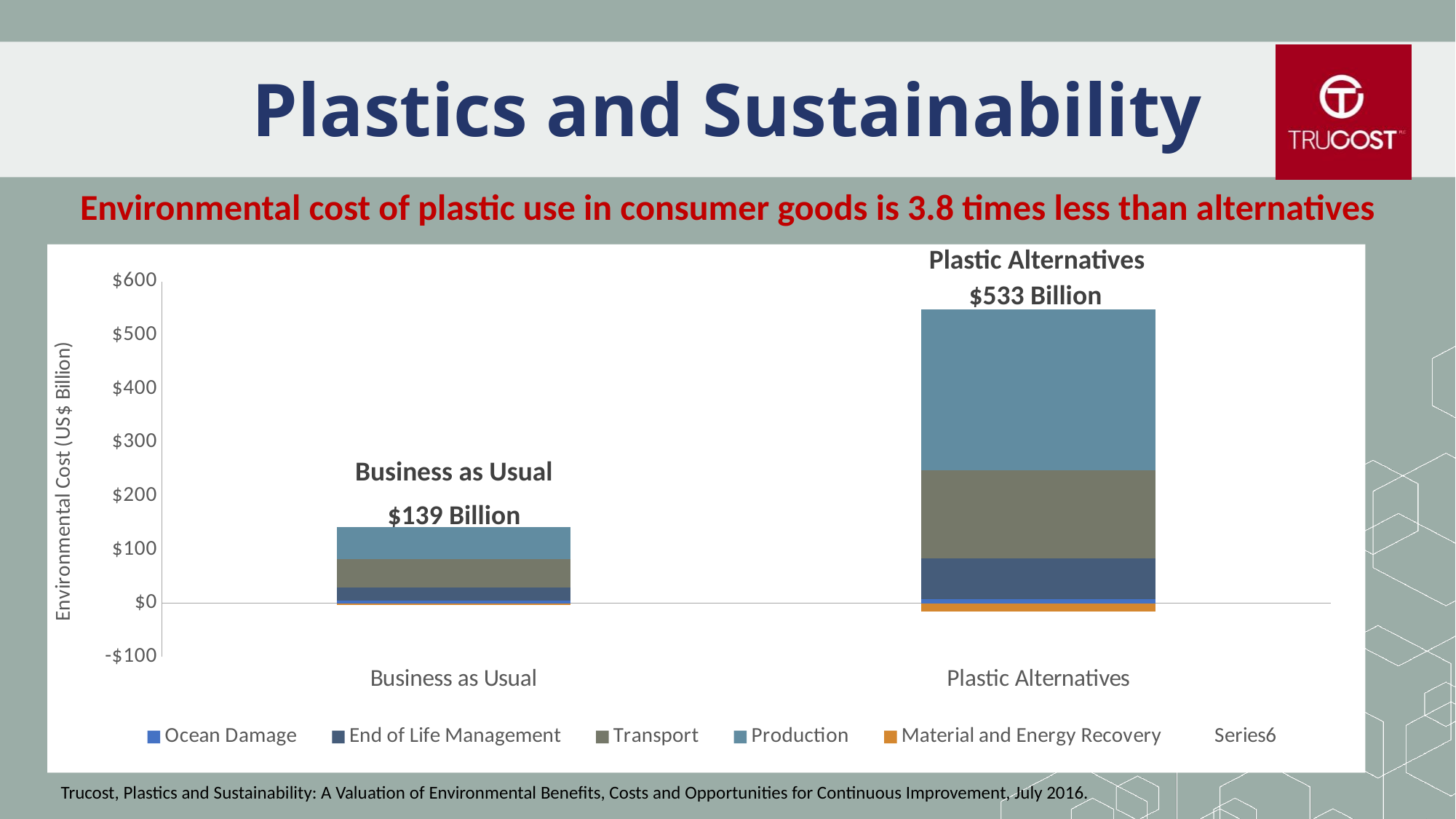
What is the label on the vertical axis of the chart? Environmental Cost (US$ Billion) What is the total environmental cost shown for Business as Usual? $139 Billion Is the total for Business as Usual larger or smaller than the total for Plastic Alternatives? smaller How many series does the chart legend list? 6 What is the difference between the Plastic Alternatives total and the Business as Usual total? $394 Billion How many categories are shown on the x axis of the chart? 2 Which category has the higher total environmental cost? Plastic Alternatives Is the End of Life Management segment of the Business as Usual bar greater or less than $100? less What is the total environmental cost shown for Plastic Alternatives? $533 Billion Is the Transport segment of the Plastic Alternatives bar greater or less than $100? greater Which category has the lower total environmental cost? Business as Usual What kind of chart is shown on the slide? Stacked bar chart